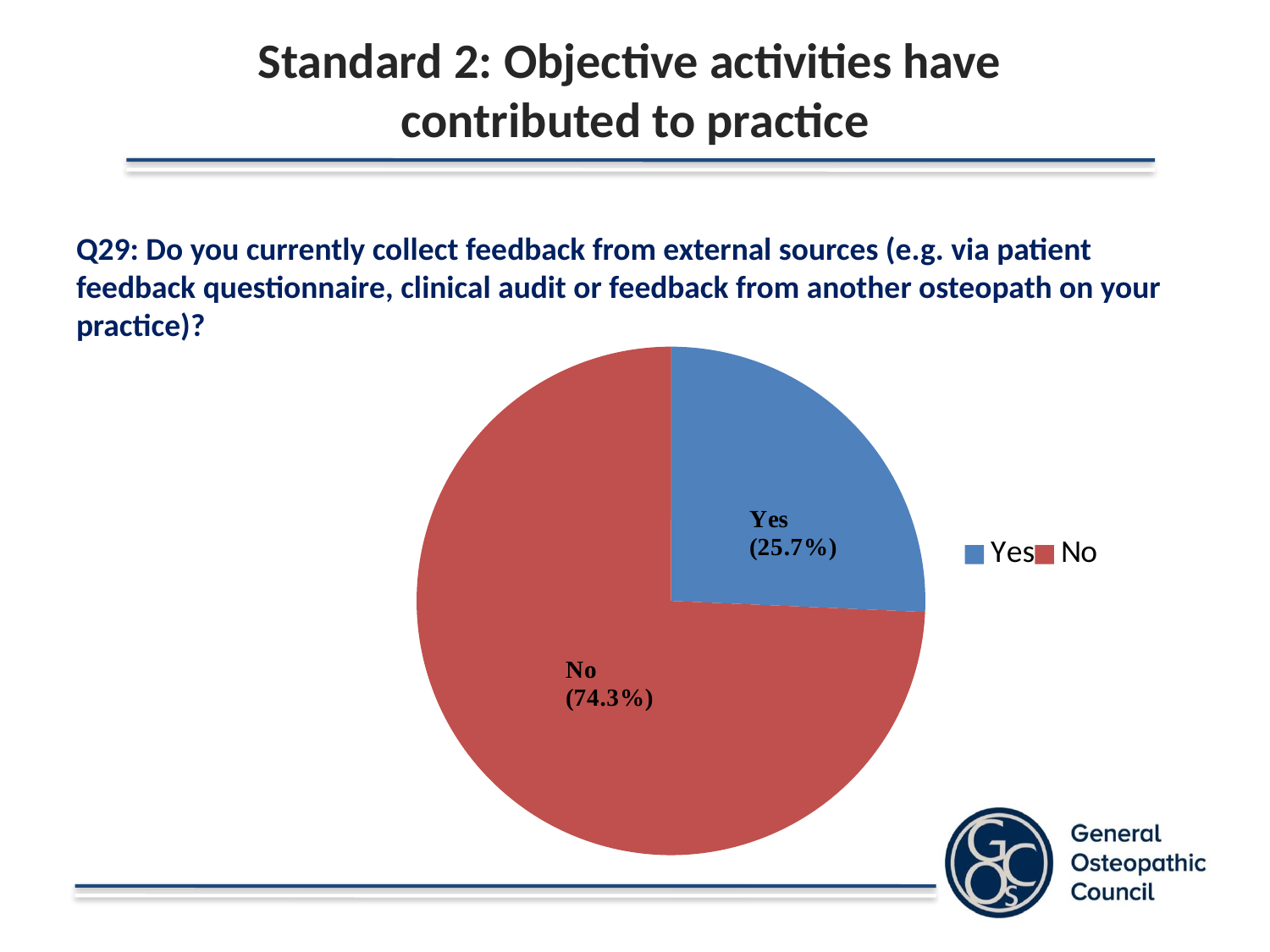
How many entries does the legend list? 2 What colour is the Yes slice? blue What is the share of the pie for the No slice? 74.3% What is the difference in percentage points between the No and Yes shares? 48.6 What percentage of respondents answered Yes? 25.7% How many slices does the pie chart have? 2 What colour is the No slice? red What kind of chart is shown on the slide? pie chart Which response has the largest share of the pie? No Which is larger, the share for Yes or the share for No? No What percentage of respondents answered No? 74.3% Which response has the smallest share of the pie? Yes